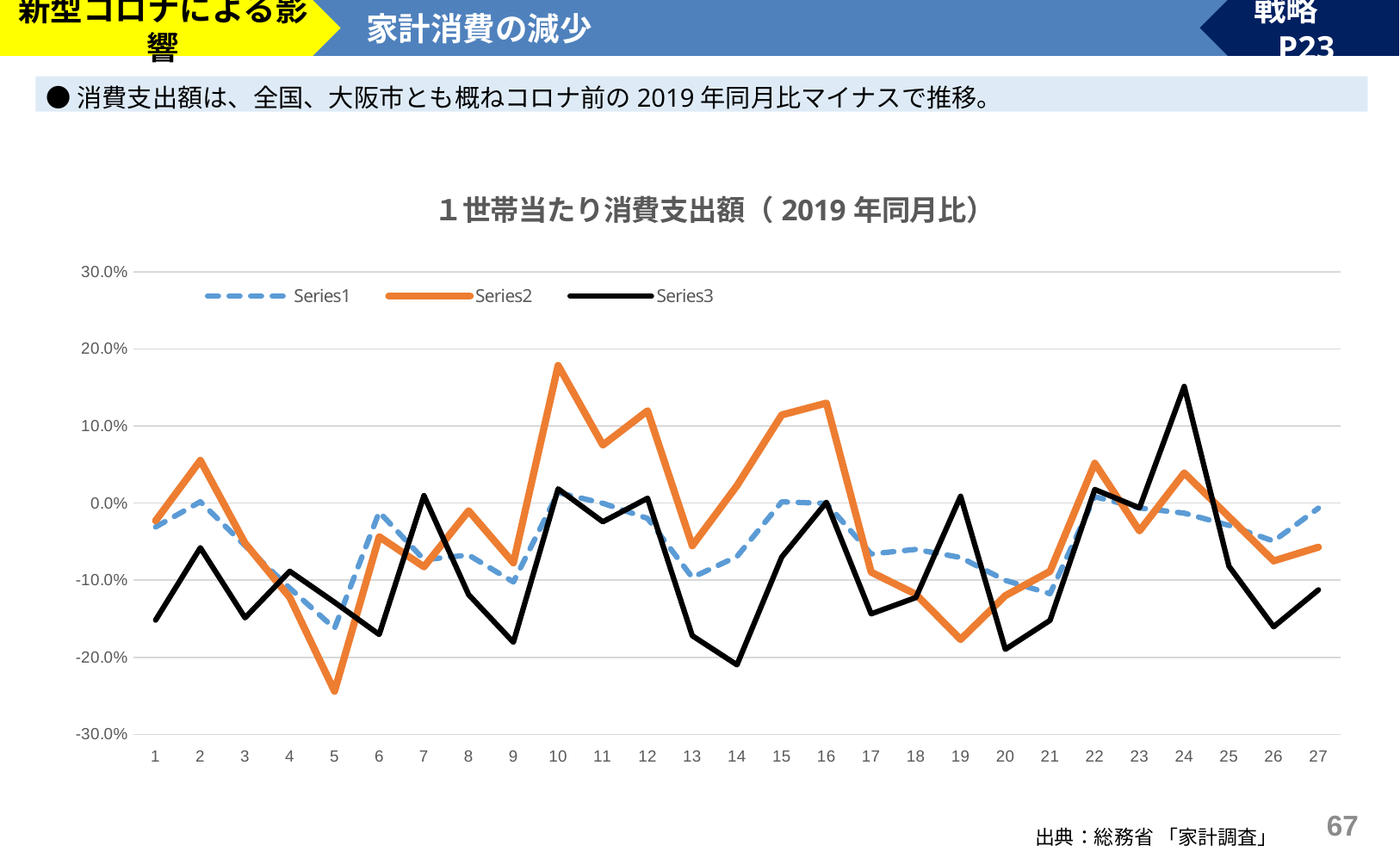
What kind of chart is shown on the slide? Line chart Is the value for Series3 at point 20 greater or less than -10.0%? less At point 24, which is larger: Series2 or Series3? Series3 What is the title of the chart? １世帯当たり消費支出額（2019年同月比） How many points are plotted along the x axis? 27 Which series is drawn as a dashed line in the legend? Series1 Is the value for Series2 at point 10 greater or less than 10.0%? greater At which x-axis point does Series2 reach its lowest value? 5 How many series does the legend list? 3 Is the value for Series2 at point 5 greater or less than -20.0%? less At which x-axis point does Series2 reach its highest value? 10